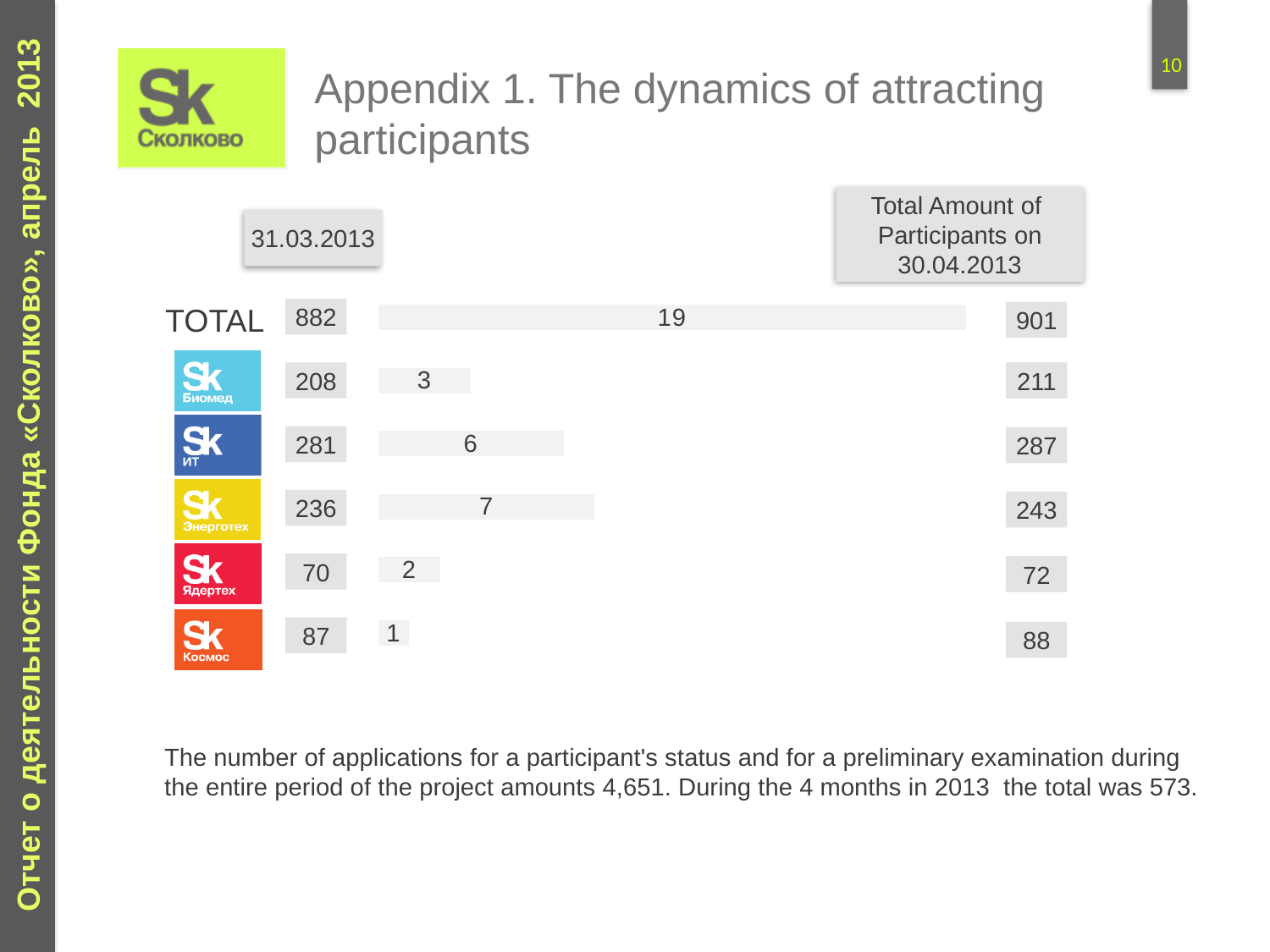
What was the number of participants for ИТ on 31.03.2013? 281 What is the difference between the TOTAL values on 30.04.2013 and 31.03.2013? 19 What is the value of the bar for Энерготех? 7 What is the difference between the 30.04.2013 and 31.03.2013 values for Ядертех? 2 What kind of chart is shown on the slide? bar chart How many cluster rows are shown below the TOTAL row? 5 What is the total amount of participants on 30.04.2013 for Космос? 88 What is the value of the bar for Биомед (the increase in participants)? 3 What is the title of the slide containing the chart? Appendix 1. The dynamics of attracting participants Which has a larger bar, ИТ or Ядертех? ИТ Excluding the TOTAL row, which cluster has the largest bar (largest increase)? Энерготех Excluding the TOTAL row, which cluster has the smallest bar (smallest increase)? Космос